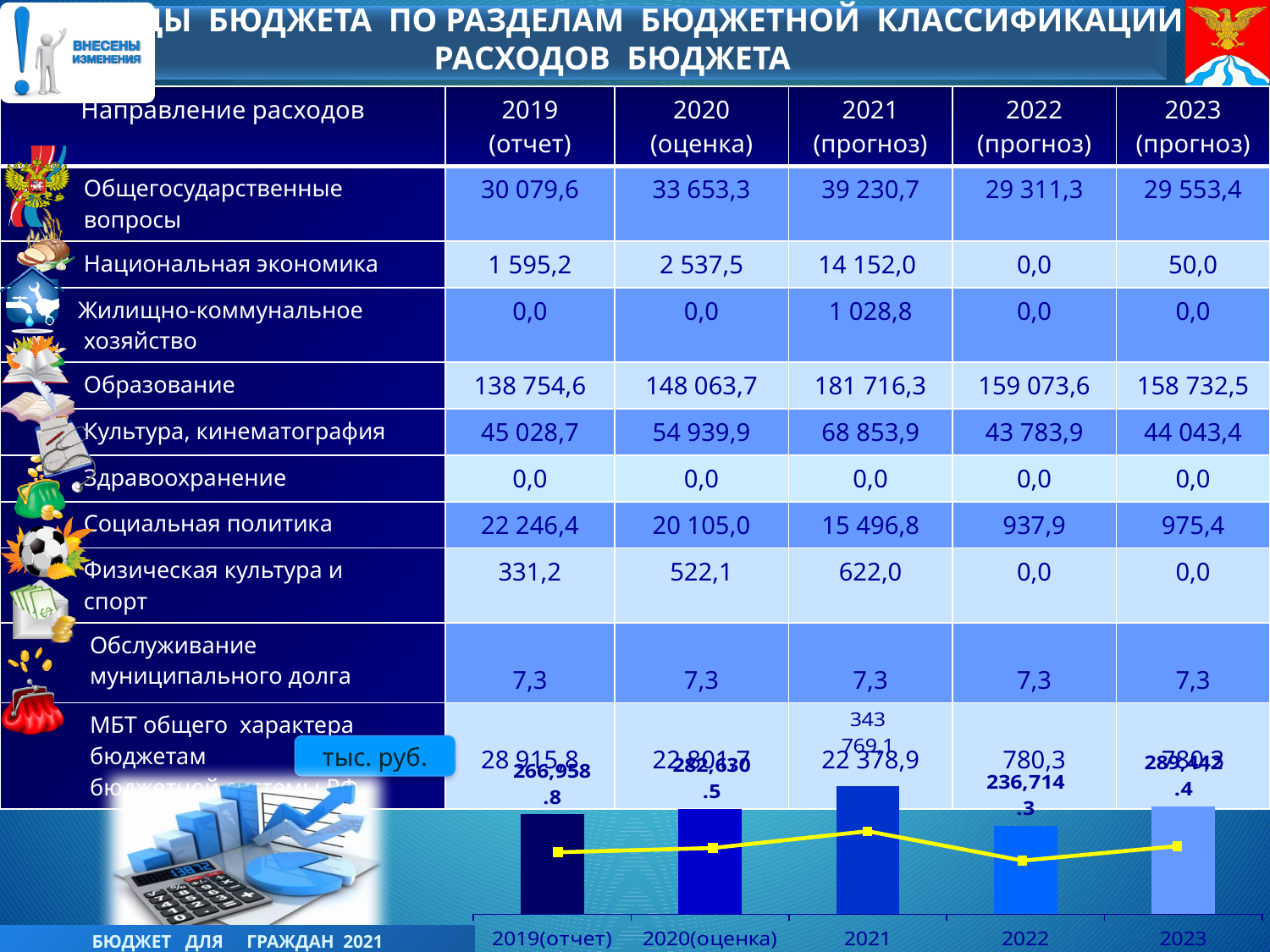
In the chart at the bottom of the slide, which year has the highest bar? 2021 How many categories (years) are shown on the x axis of the chart at the bottom of the slide? 5 What kind of chart is shown at the bottom of the slide? bar chart In the chart at the bottom of the slide, what is the value for 2022? 236,714.3 In the chart at the bottom of the slide, which is larger: the value for 2019(отчет) or for 2020(оценка)? 2020(оценка) In the chart at the bottom of the slide, which year has the lowest bar? 2022 What colour is the line overlaid on the bars in the chart at the bottom of the slide? yellow In the chart at the bottom of the slide, what is the value for 2020(оценка)? 282,630.5 In the chart at the bottom of the slide, what is the value for 2019(отчет)? 266,958.8 In the chart at the bottom of the slide, what is the difference between the values for 2019(отчет) and 2022? 30,244.5 In the chart at the bottom of the slide, what is the difference between the values for 2020(оценка) and 2019(отчет)? 15,671.7 In the chart at the bottom of the slide, do the values rise or fall from 2019(отчет) to 2021? rise